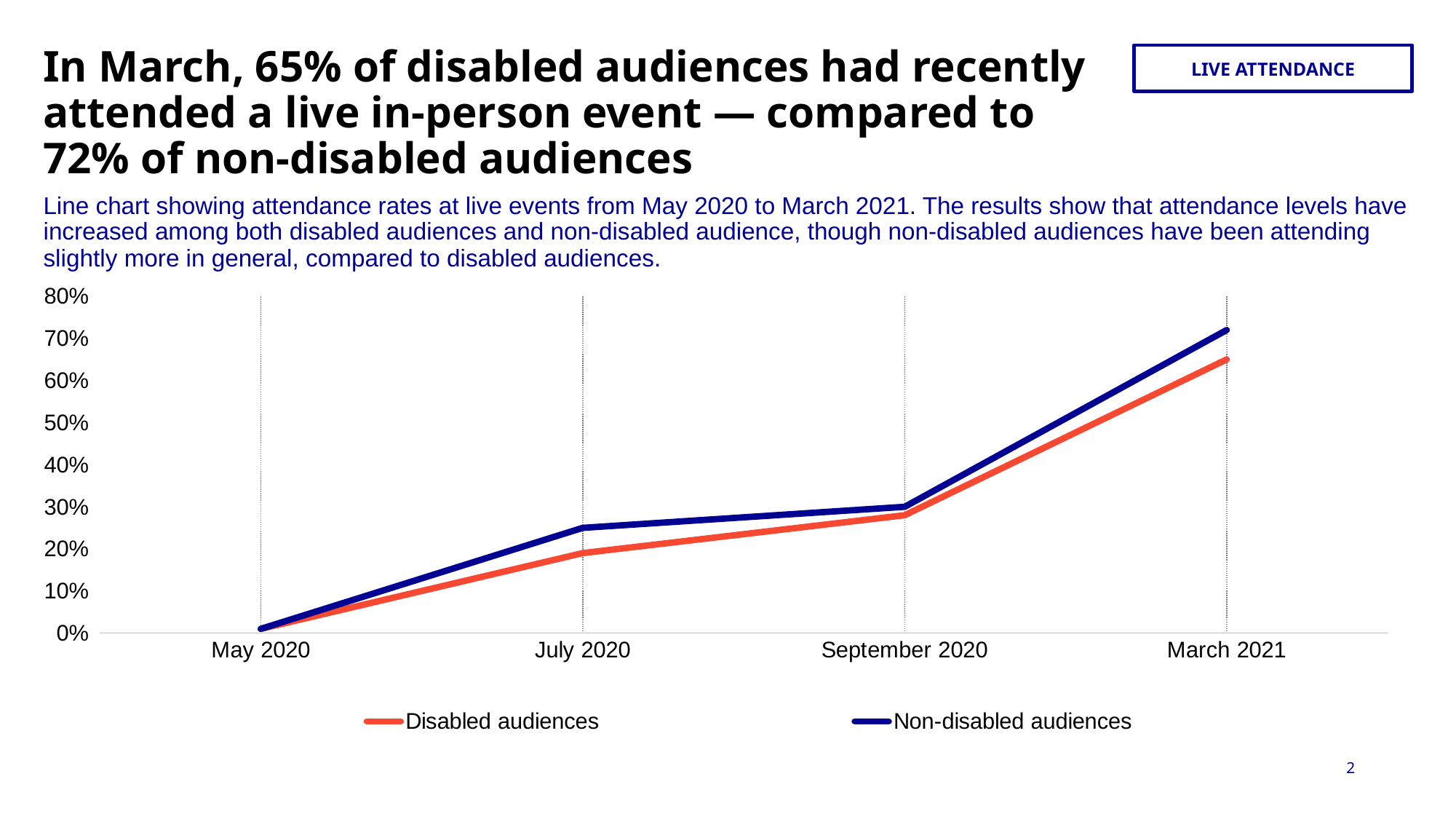
In March 2021, how much higher was the attendance rate for non-disabled audiences than for disabled audiences? 7 percentage points Is the value for non-disabled audiences in July 2020 greater or less than 20%? greater How many series does the chart's legend list? 2 In July 2020, which series has the higher attendance rate: disabled audiences or non-disabled audiences? Non-disabled audiences Is the value for disabled audiences in September 2020 greater or less than 40%? less What kind of chart is shown on the slide? Line chart At which time point is the attendance rate for non-disabled audiences lowest? May 2020 What was the attendance rate for disabled audiences in March 2021? 65% What was the attendance rate for non-disabled audiences in March 2021? 72% Do the attendance rates rise or fall from May 2020 to March 2021? Rise How many time points are plotted along the x axis of the chart? 4 At which time point is the attendance rate for disabled audiences highest? March 2021